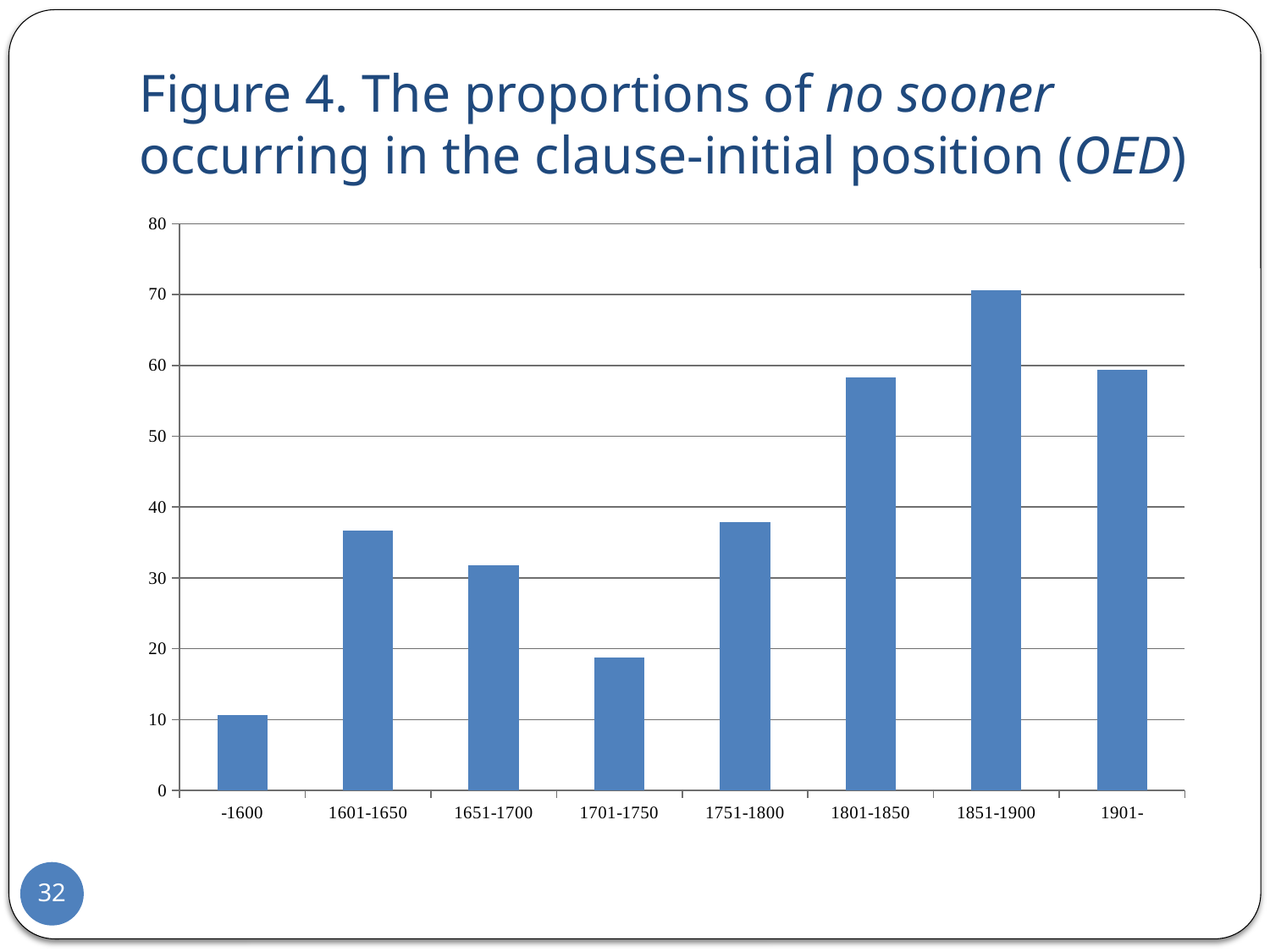
Which period has the highest bar in the chart? 1851-1900 Is the value for 1701-1750 greater or less than 20? less Is the value for 1651-1700 greater or less than 40? less Which period has the lowest bar in the chart? -1600 How many time periods are shown on the x axis of the chart? 8 What kind of chart is shown on the slide? bar chart Which is larger, the value for 1851-1900 or the value for 1901-? 1851-1900 Is the value for -1600 greater or less than 20? less Which is larger, the value for 1651-1700 or the value for 1701-1750? 1651-1700 According to the slide title, which source is the data in Figure 4 taken from? OED